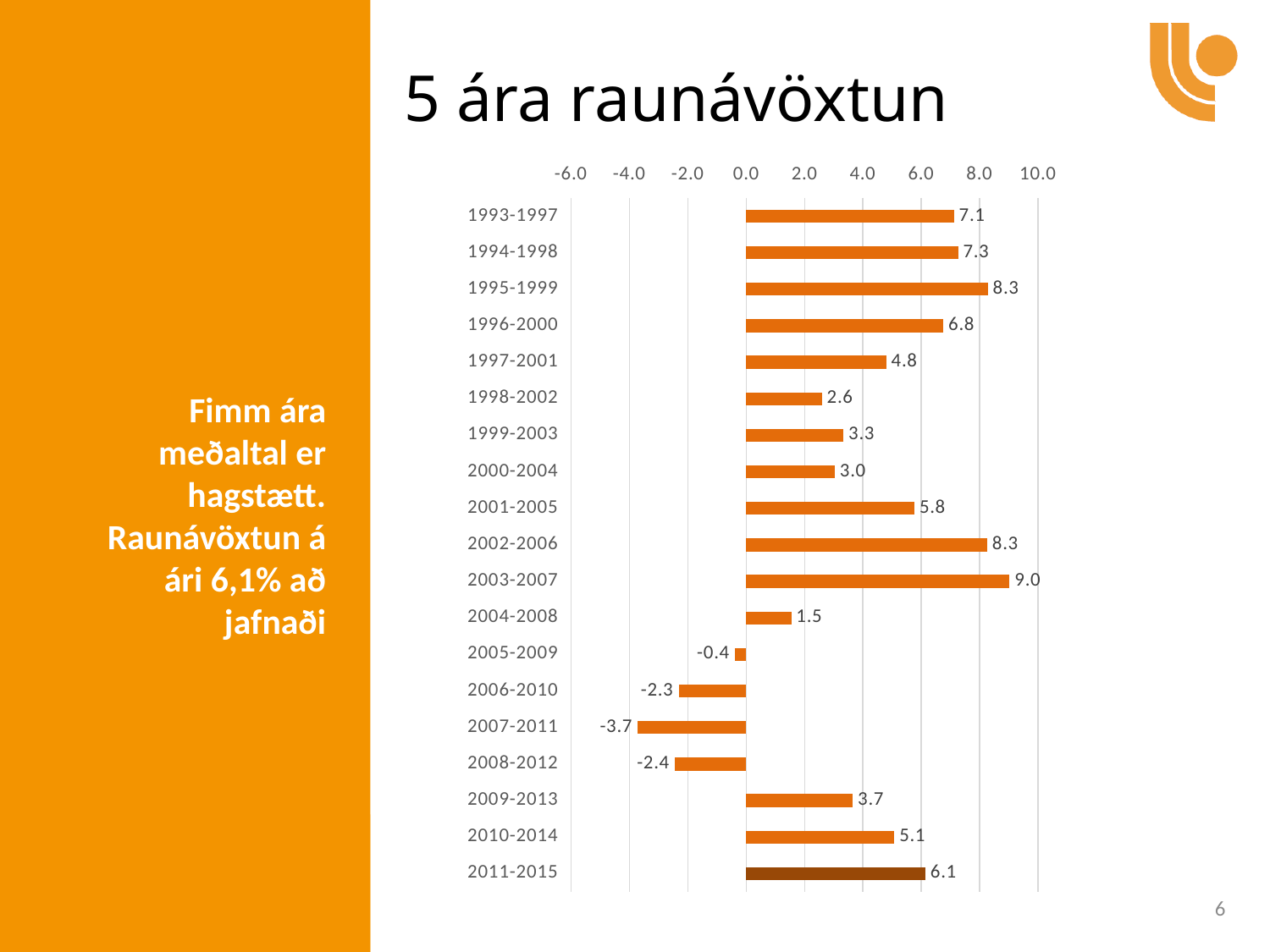
What is the value for 2003-2007? 9.0 What kind of chart is shown on the slide? Bar chart Which period has the lowest value? 2007-2011 How many periods are shown on the chart? 19 Which is larger, the value for 1997-2001 or the value for 2001-2005? 2001-2005 What is the difference between the values for 1995-1999 and 1993-1997? 1.2 What is the difference between the values for 2003-2007 and 2007-2011? 12.7 Is the value for 1996-2000 greater or less than 6.0? greater What is the value for 2007-2011? -3.7 Which period has the highest value? 2003-2007 How many periods have a negative value? 4 What is the value for 2011-2015? 6.1